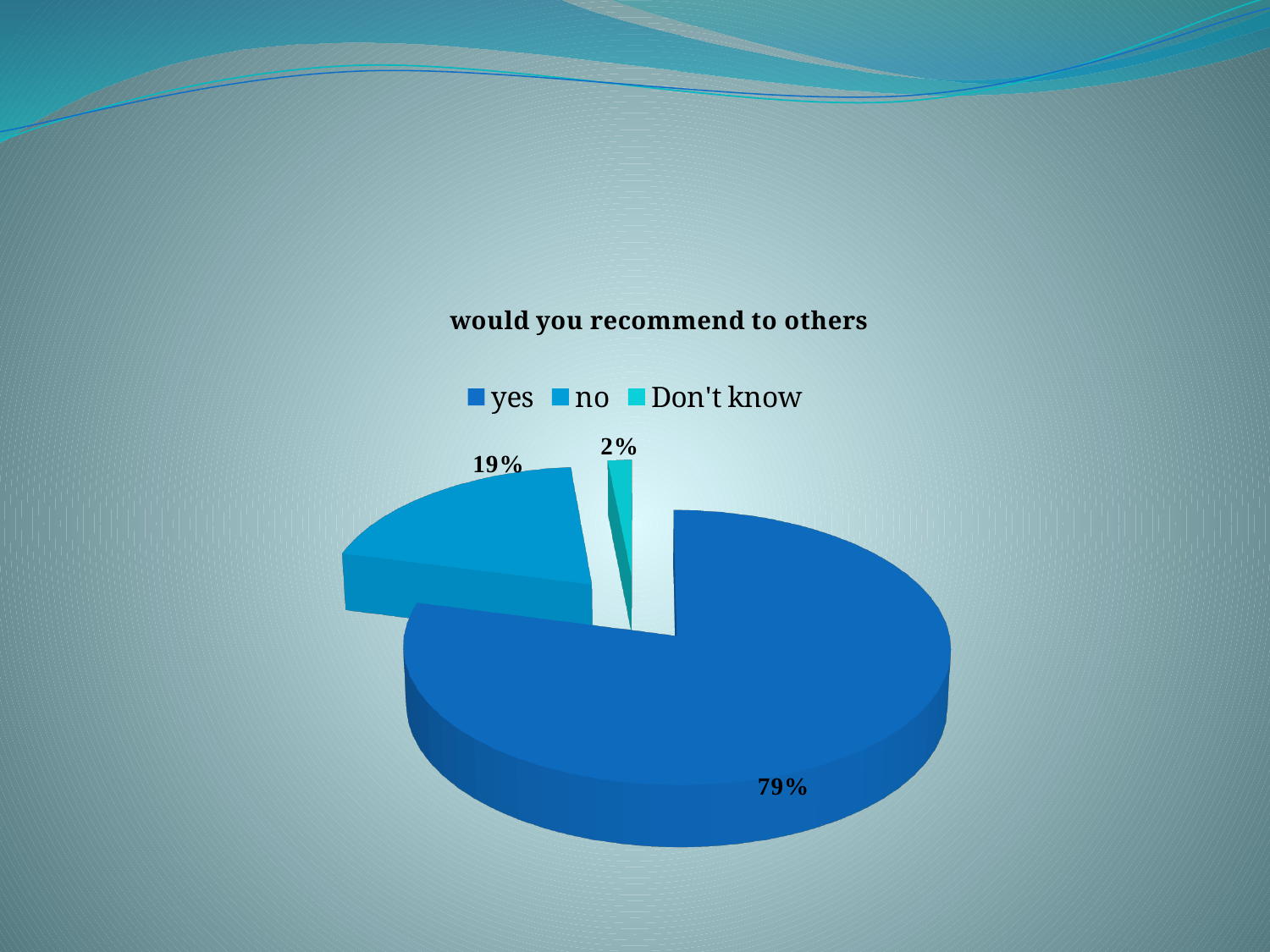
Which is larger, the share for "no" or the share for "Don't know"? no What is the title of the chart? would you recommend to others Which category has the smallest share of the pie? Don't know What kind of chart is shown on the slide? pie chart Which category has the largest share of the pie? yes Which legend entry is shown in the lightest (cyan) colour? Don't know What percentage of the pie is the "Don't know" slice? 2% How many categories does the legend list? 3 What percentage of the pie is the "no" slice? 19% What percentage of the pie is the "yes" slice? 79% What is the difference in percentage points between the "yes" and "no" slices? 60 What is the difference in percentage points between the "no" and "Don't know" slices? 17